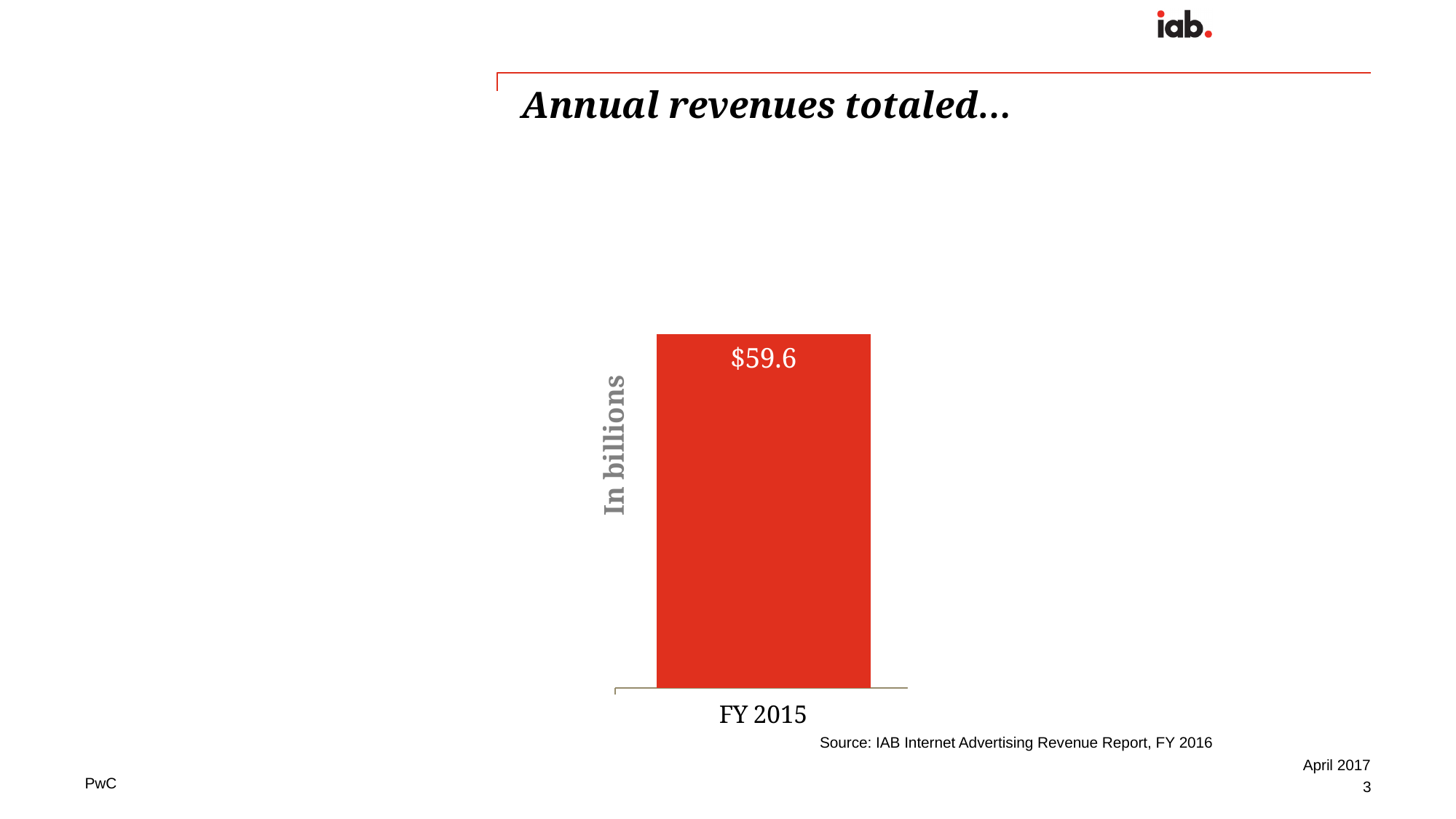
What is the label of the vertical axis? In billions What category label appears under the bar? FY 2015 How many bars are plotted in the chart? 1 What kind of chart is shown on the slide? bar chart What is the value shown for FY 2015? $59.6 Is the value for FY 2015 greater or less than $50 billion? greater